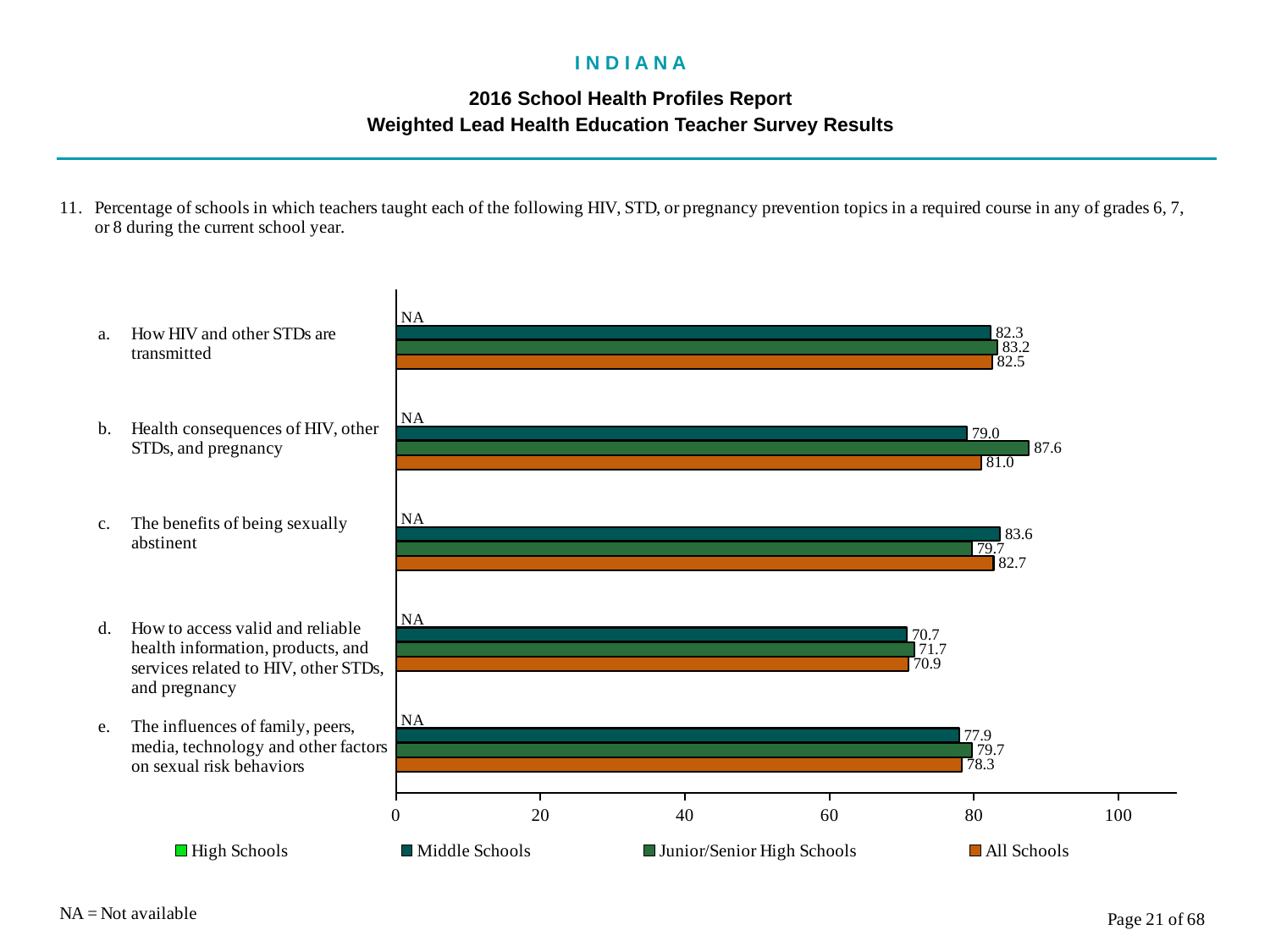
How many topics (categories) are shown in the chart? 5 For 'The benefits of being sexually abstinent', which is larger: the Middle Schools value or the Junior/Senior High Schools value? Middle Schools What is the Middle Schools value for 'How HIV and other STDs are transmitted'? 82.3 What is the All Schools value for 'The influences of family, peers, media, technology and other factors on sexual risk behaviors'? 78.3 What kind of chart is shown on the slide? bar chart How many series does the legend list? 4 For 'Health consequences of HIV, other STDs, and pregnancy', what is the difference between the Junior/Senior High Schools value and the Middle Schools value? 8.6 Is the All Schools value for 'How to access valid and reliable health information, products, and services related to HIV, other STDs, and pregnancy' greater or less than 80? less What is shown for the High Schools series for each topic? NA What is the Junior/Senior High Schools value for 'Health consequences of HIV, other STDs, and pregnancy'? 87.6 Which topic has the lowest Middle Schools value? How to access valid and reliable health information, products, and services related to HIV, other STDs, and pregnancy Which topic has the highest Junior/Senior High Schools value? Health consequences of HIV, other STDs, and pregnancy